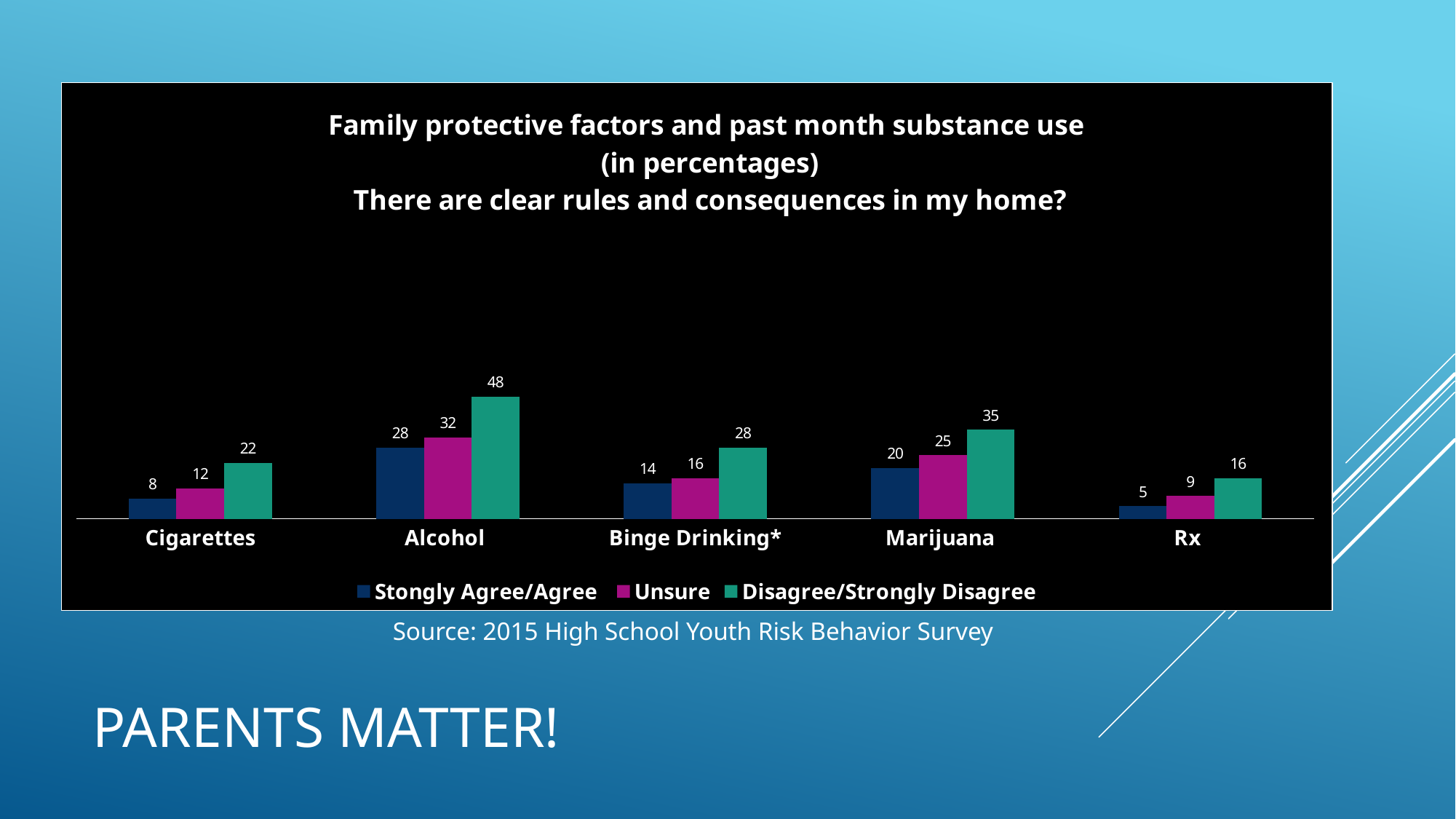
What is the value for Rx in the Unsure series? 9 Which category has the highest value in the Disagree/Strongly Disagree series? Alcohol How many series does the legend list? 3 What is the value for Marijuana in the Stongly Agree/Agree series? 20 What is the difference between the Disagree/Strongly Disagree and Stongly Agree/Agree values for Cigarettes? 14 Which is larger: the Unsure value for Marijuana or the Unsure value for Binge Drinking*? Marijuana Which category has the lowest value in the Stongly Agree/Agree series? Rx What is the source cited below the chart? 2015 High School Youth Risk Behavior Survey What kind of chart is shown on the slide? Bar chart What is the value for Alcohol in the Disagree/Strongly Disagree series? 48 What is the difference between the Disagree/Strongly Disagree and Unsure values for Binge Drinking*? 12 How many categories are shown on the x axis? 5